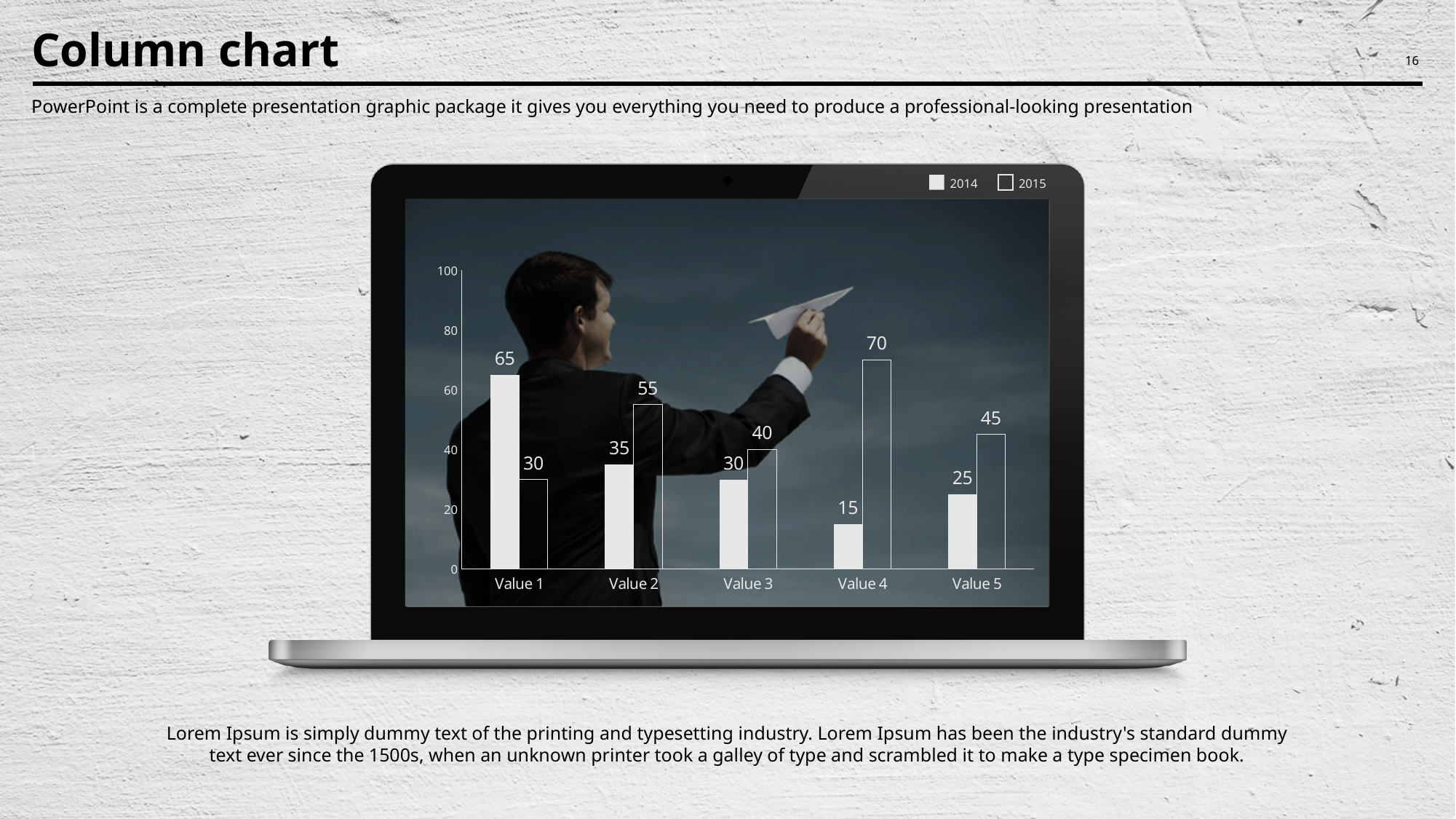
What is the 2014 value for Value 1? 65 What is the 2015 value for Value 4? 70 Which category has the lowest 2014 value? Value 4 Is the 2015 value for Value 2 greater or less than 40? greater Which is larger for Value 1, the 2014 value or the 2015 value? 2014 What kind of chart is shown on the slide? Bar chart Which category has the highest 2015 value? Value 4 What are the two series named in the legend? 2014 and 2015 How many categories are shown on the x axis? 5 What is the 2014 value for Value 5? 25 What is the difference between the 2015 and 2014 values for Value 4? 55 How many series does the legend list? 2